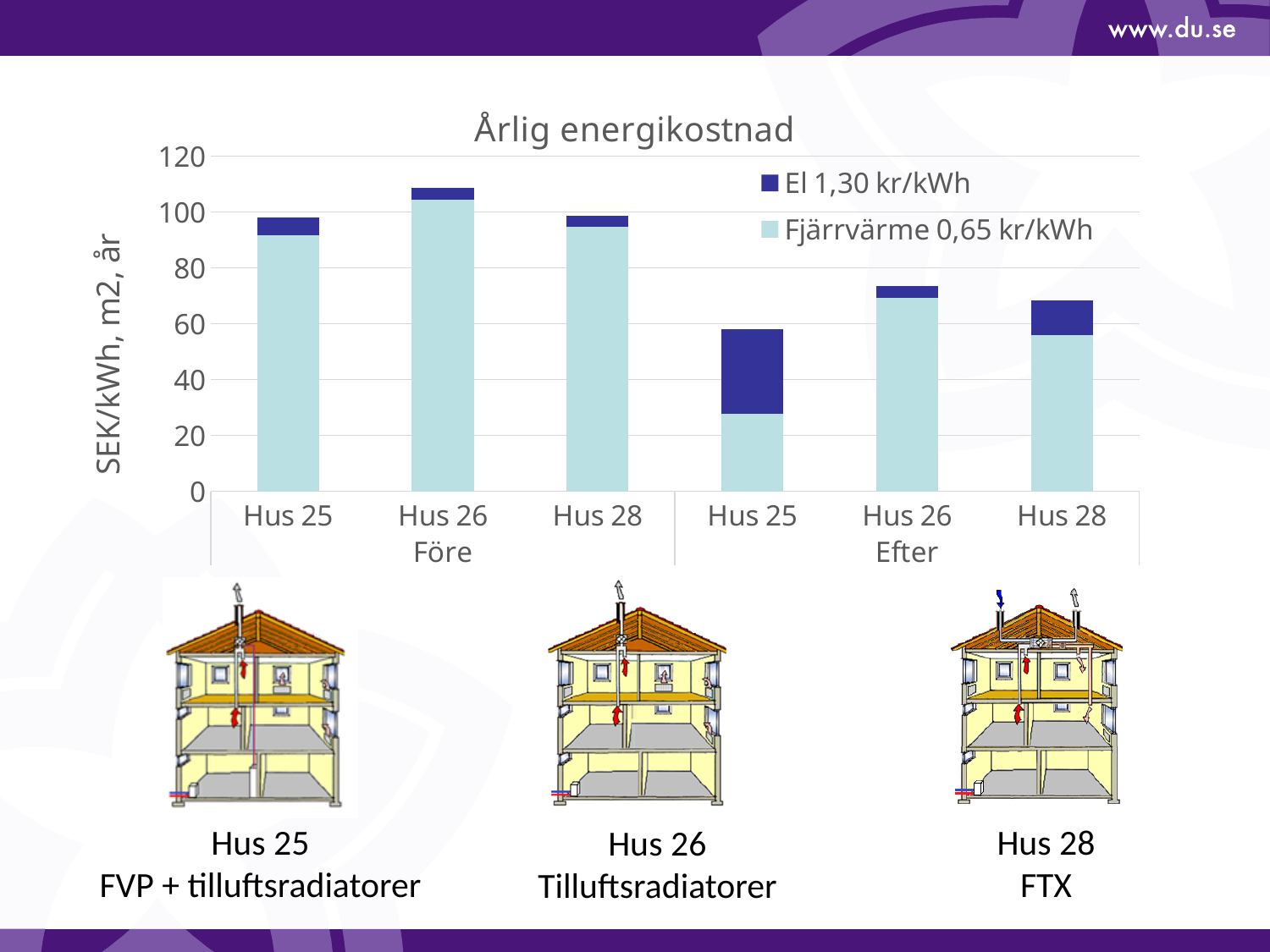
What is the title of the chart? Årlig energikostnad Which is larger, the total for Hus 26 Före or the total for Hus 26 Efter? Hus 26 Före Is the total value for Hus 28 Efter greater or less than 80? less Is the total value for Hus 25 Efter greater or less than 40? greater Which bar has the highest total annual energy cost? Hus 26 Före What type of chart is shown on the slide? Stacked bar chart How many bars are plotted in the chart? 6 What are the two series named in the legend? El 1,30 kr/kWh and Fjärrvärme 0,65 kr/kWh Which is larger, the El portion for Hus 25 Före or the El portion for Hus 25 Efter? Hus 25 Efter Which bar has the lowest total annual energy cost? Hus 25 Efter Is the total value for Hus 26 Före greater or less than 100? greater How many series does the chart legend list? 2